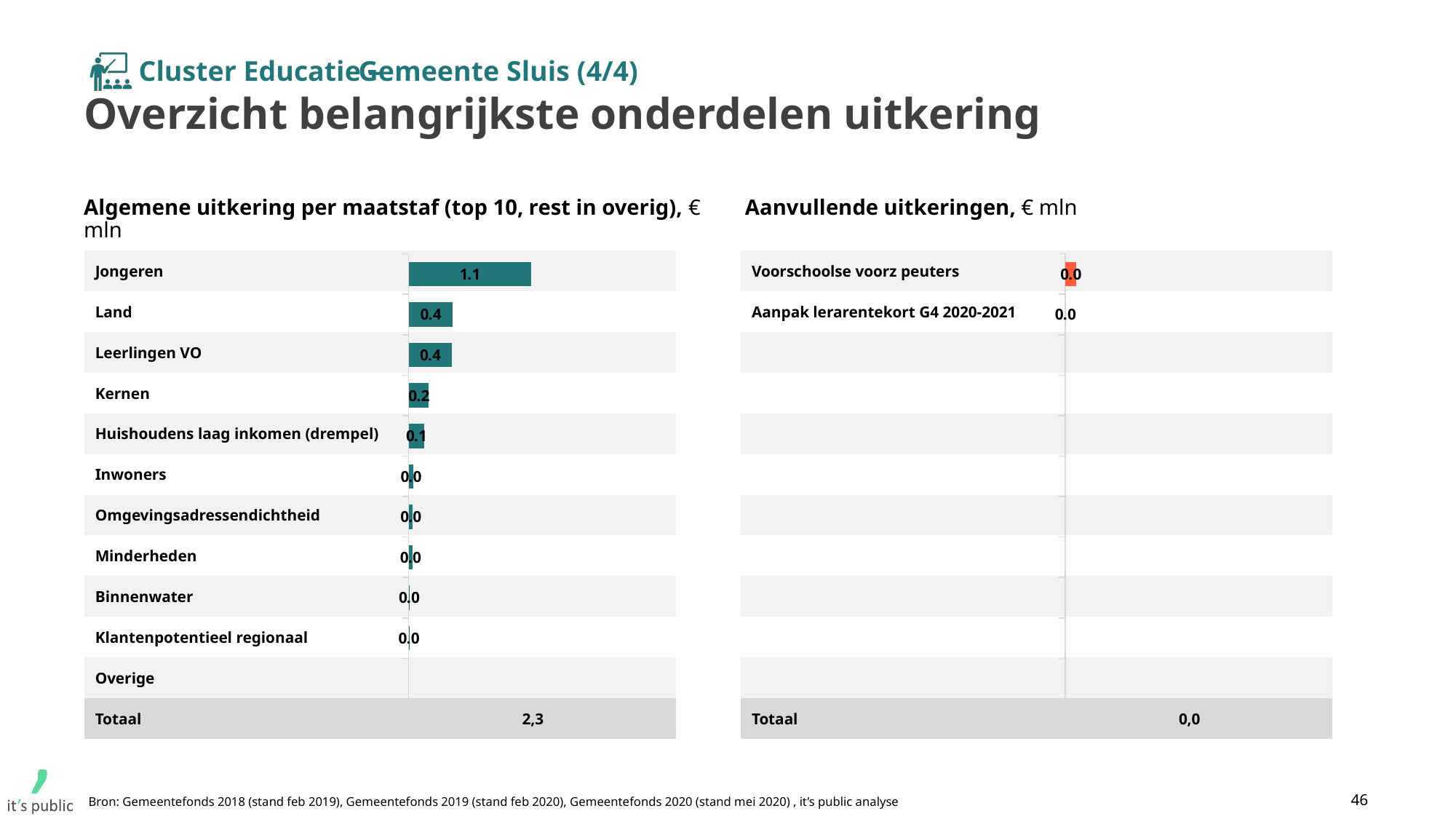
What kind of chart is the left chart 'Algemene uitkering per maatstaf'? Bar chart In the left chart 'Algemene uitkering per maatstaf', what is the difference between the values for Jongeren and Land? 0.7 What is the title of the right chart? Aanvullende uitkeringen, € mln In the left chart 'Algemene uitkering per maatstaf', which is larger: the value for Kernen or the value for Huishoudens laag inkomen (drempel)? Kernen In the left chart 'Algemene uitkering per maatstaf', which category has the highest value? Jongeren In the left chart 'Algemene uitkering per maatstaf', what is the value for Kernen? 0.2 In the left chart 'Algemene uitkering per maatstaf', what is the Totaal value shown at the bottom? 2,3 In the right chart 'Aanvullende uitkeringen', what is the value for Voorschoolse voorz peuters? 0.0 In the left chart 'Algemene uitkering per maatstaf', what is the value for Jongeren? 1.1 In the right chart 'Aanvullende uitkeringen', what is the Totaal value shown at the bottom? 0,0 In the left chart 'Algemene uitkering per maatstaf', do the values rise or fall going from the top category to the bottom? Fall In the left chart 'Algemene uitkering per maatstaf', how many categories show a value of 0.0? 5